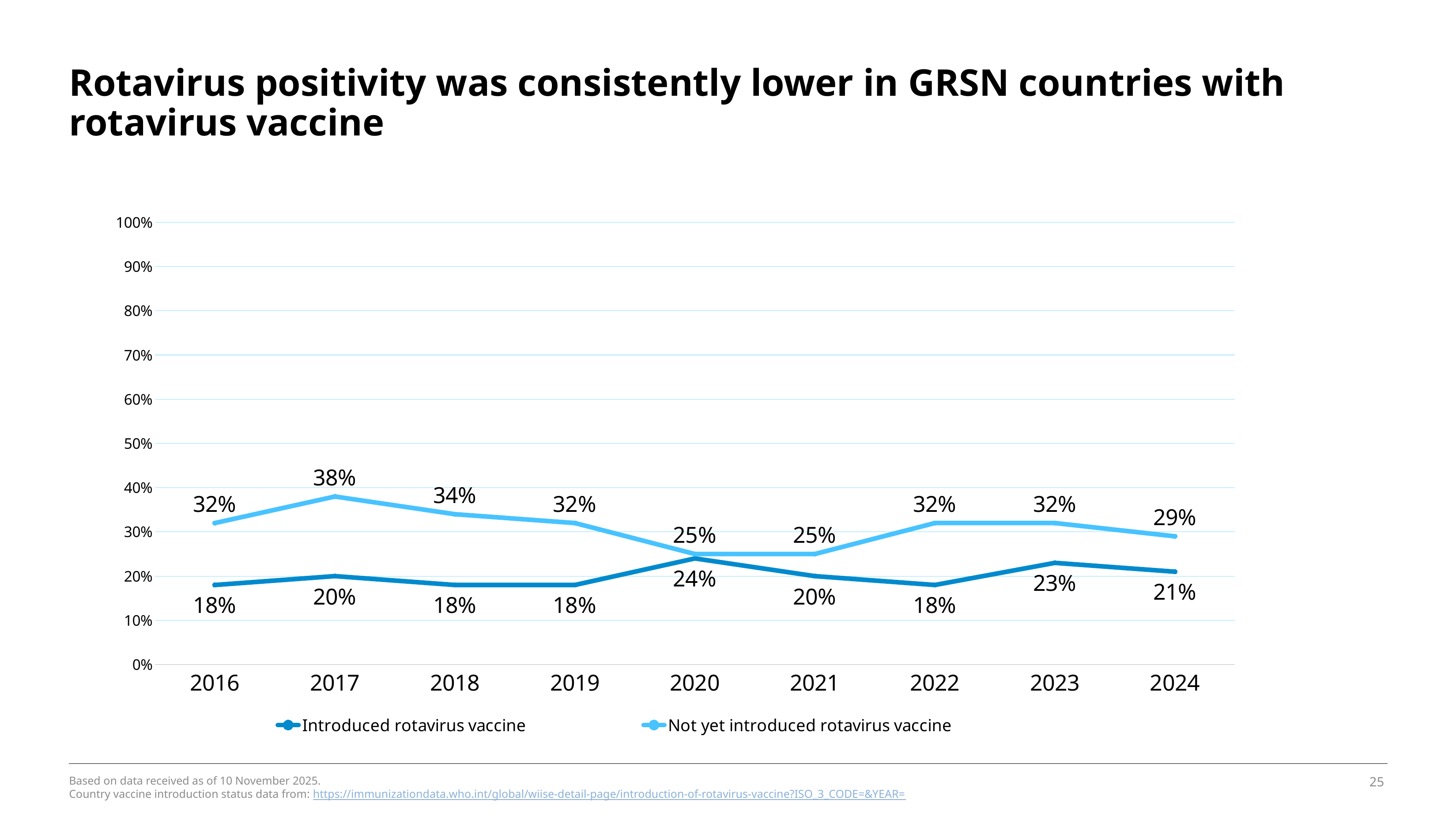
What is the difference between the two series in 2020? 1% Which series has the larger value in 2022? Not yet introduced rotavirus vaccine What was the rotavirus positivity in 2017 for countries that had not yet introduced rotavirus vaccine? 38% In which year was the value for 'Not yet introduced rotavirus vaccine' highest? 2017 Does the value for 'Not yet introduced rotavirus vaccine' rise or fall from 2017 to 2021? fall In which year was the value for 'Introduced rotavirus vaccine' highest? 2020 What is the difference between the two series in 2017? 18% What is the label of the darker blue series in the legend? Introduced rotavirus vaccine What kind of chart is shown on the slide? line chart How many series does the legend list? 2 How many years are shown on the x axis? 9 What was the rotavirus positivity in 2023 for countries that introduced rotavirus vaccine? 23%